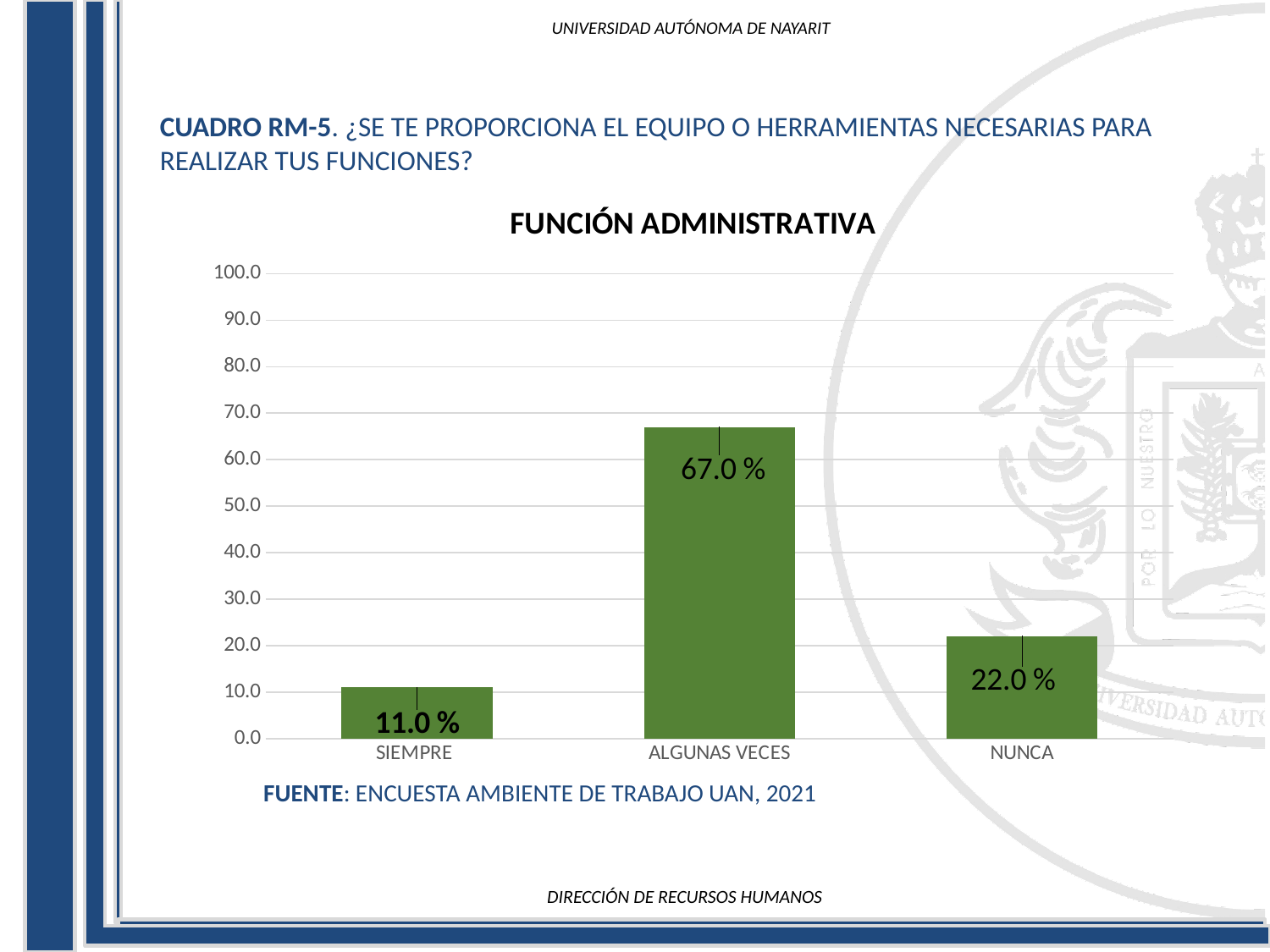
What is the difference between the values for NUNCA and SIEMPRE? 11.0 % What is the value for NUNCA? 22.0 % What is the title of the chart? FUNCIÓN ADMINISTRATIVA Is the value for ALGUNAS VECES greater or less than 60.0? greater Which category has the lowest value? SIEMPRE Which category has the highest value? ALGUNAS VECES How many categories are shown on the x axis? 3 What is the value for SIEMPRE? 11.0 % Which is larger, the value for NUNCA or the value for SIEMPRE? NUNCA What is the difference between the values for ALGUNAS VECES and NUNCA? 45.0 % What kind of chart is shown on the slide? bar chart What is the value for ALGUNAS VECES? 67.0 %